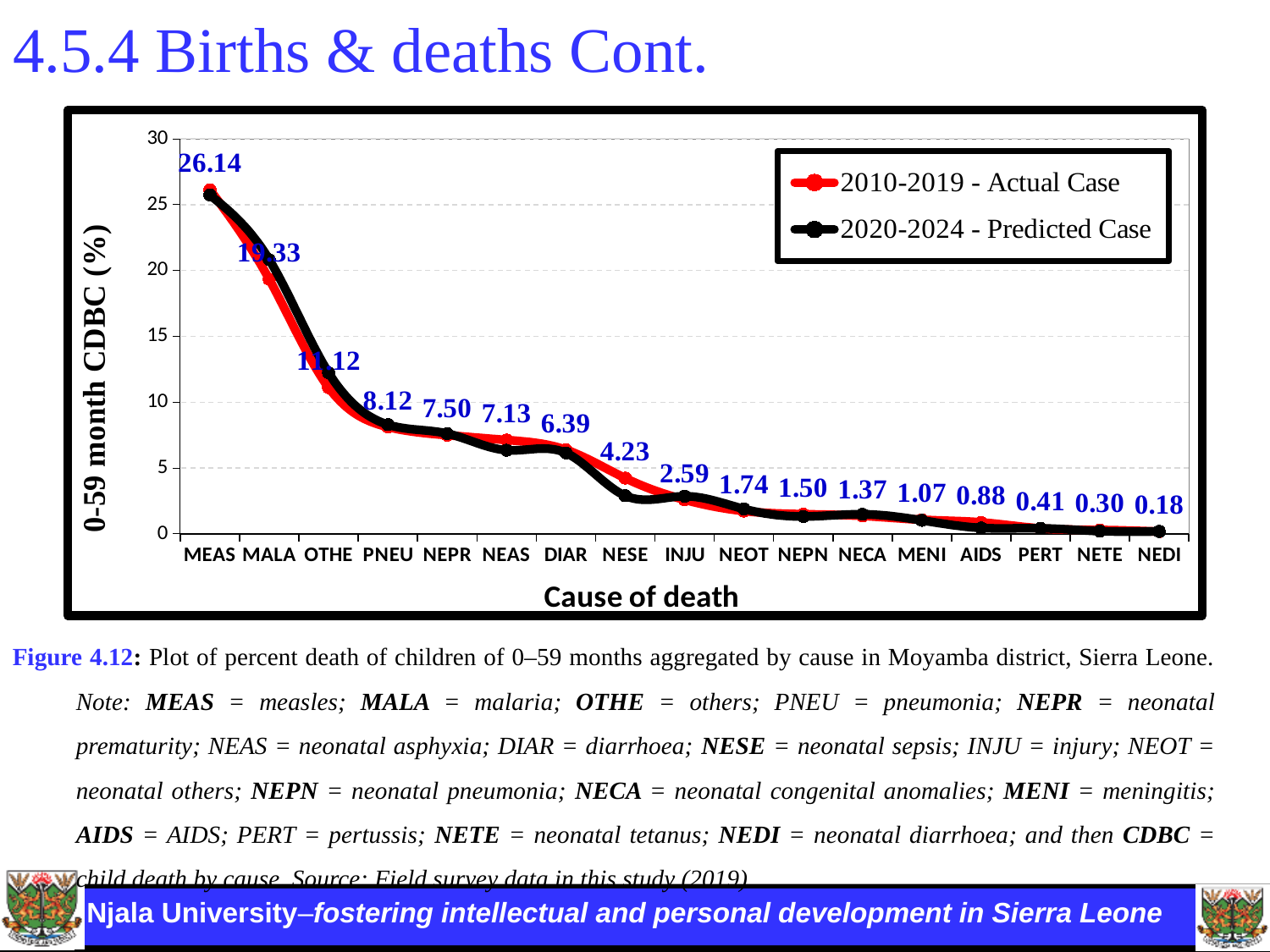
How many causes of death are shown on the x axis? 17 What type of chart is shown on the slide? line chart Which cause of death has the lowest labelled value? NEDI What is the difference between the labelled values for MEAS and MALA? 6.81 What is the data label shown for MEAS (measles)? 26.14 Which has a larger labelled value, PNEU or NESE? PNEU Which cause of death has the highest labelled value? MEAS Do the values rise or fall moving from left to right along the x axis? fall What is the data label shown for DIAR (diarrhoea)? 6.39 What is the data label shown for NEDI (neonatal diarrhoea)? 0.18 How many series does the legend list? 2 What is the label of the y axis? 0-59 month CDBC (%)